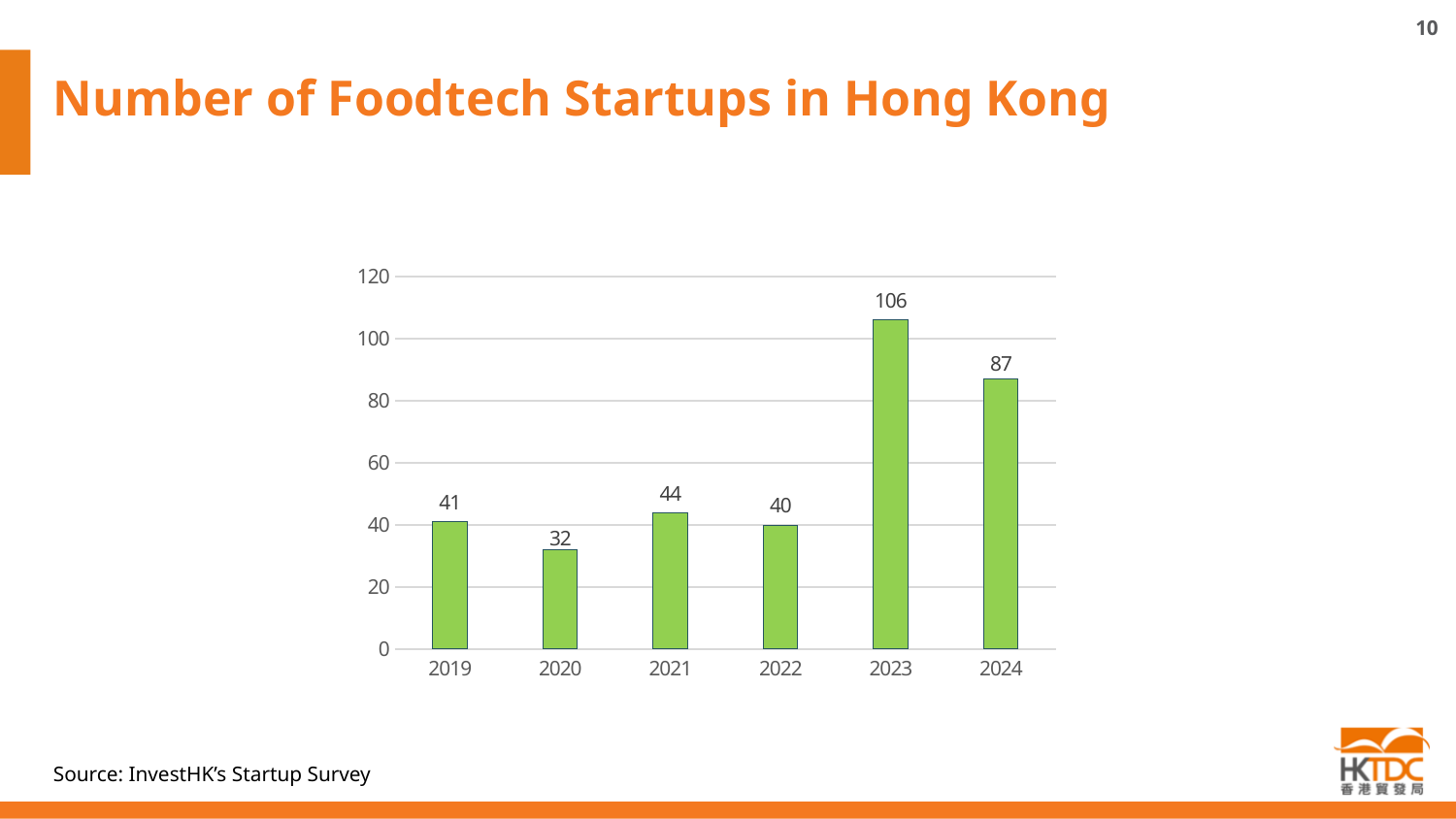
What is the difference between the number of foodtech startups in 2023 and 2024? 19 What kind of chart is shown on the slide? Bar chart Is the number of foodtech startups in 2024 greater or less than 80? greater Which year has more foodtech startups, 2019 or 2022? 2019 What is the number of foodtech startups in Hong Kong in 2024? 87 What is the number of foodtech startups in Hong Kong in 2023? 106 Which year has the lowest number of foodtech startups? 2020 How many years are shown on the chart? 6 Which year has the highest number of foodtech startups? 2023 What is the source of the data shown in the chart? InvestHK's Startup Survey What is the number of foodtech startups in Hong Kong in 2020? 32 What is the difference between the number of foodtech startups in 2021 and 2020? 12